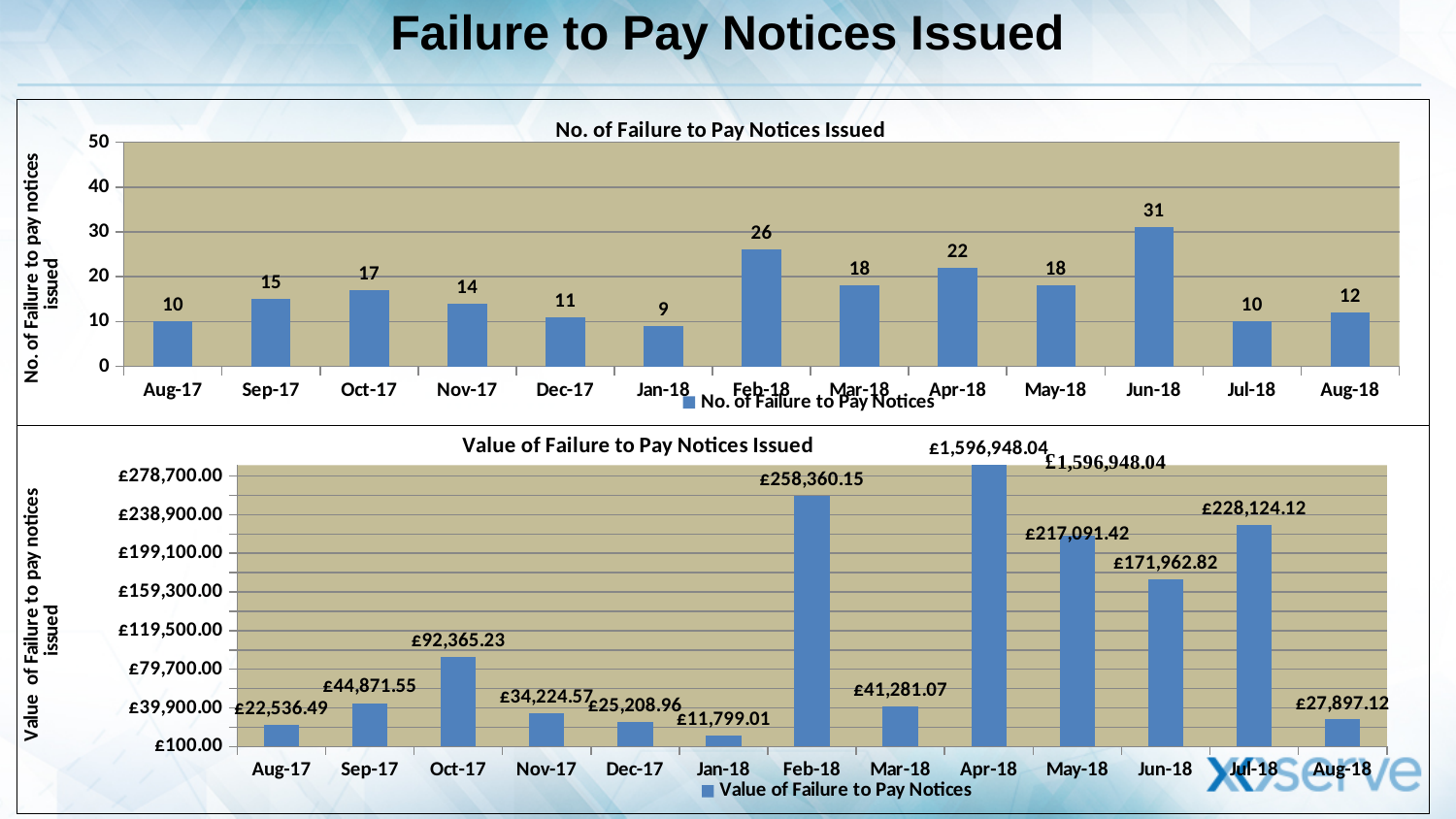
In the 'No. of Failure to Pay Notices Issued' chart, how many notices were issued in Feb-18? 26 In the 'Value of Failure to Pay Notices Issued' chart, which month has the highest value? Apr-18 In the 'Value of Failure to Pay Notices Issued' chart, which month has the lowest value? Jan-18 In the 'No. of Failure to Pay Notices Issued' chart, how many months are shown on the x axis? 13 In the 'Value of Failure to Pay Notices Issued' chart, which is larger: the value for May-18 or the value for Jul-18? Jul-18 In the 'Value of Failure to Pay Notices Issued' chart, what is the value for Oct-17? £92,365.23 How many series does the legend of the 'Value of Failure to Pay Notices Issued' chart list? 1 In the 'Value of Failure to Pay Notices Issued' chart, what is the difference between the values for Feb-18 and Mar-18? £217,079.08 In the 'No. of Failure to Pay Notices Issued' chart, what is the difference between the number of notices in Jun-18 and Jul-18? 21 In the 'No. of Failure to Pay Notices Issued' chart, which month has the highest number of notices? Jun-18 In the 'No. of Failure to Pay Notices Issued' chart, which month has the lowest number of notices? Jan-18 What type of chart is the 'No. of Failure to Pay Notices Issued' chart? Bar chart